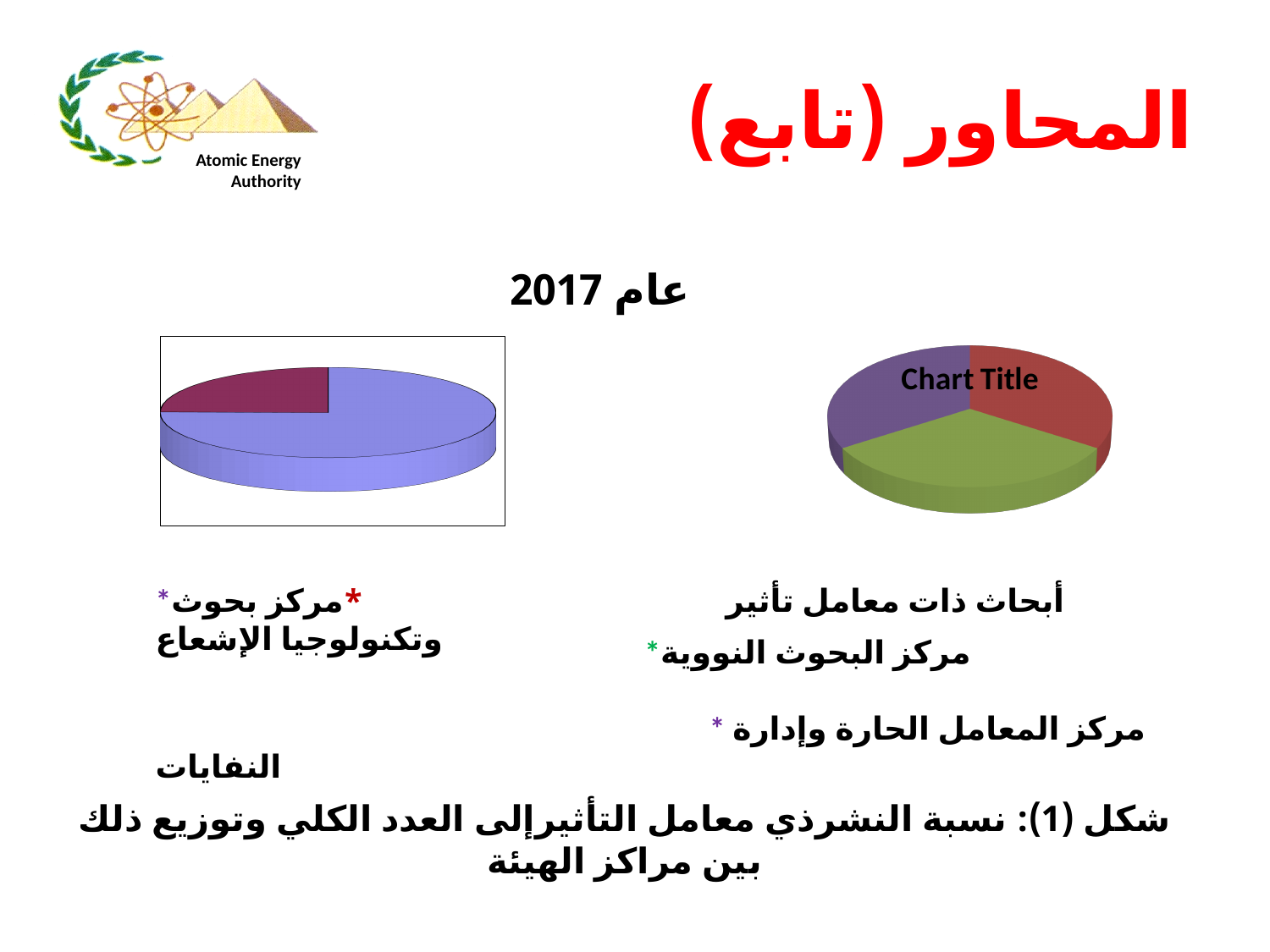
In the pie chart on the left side of the slide, which slice is the smallest? the maroon slice What is the title printed on the pie chart on the right side of the slide? Chart Title How many charts are shown on the slide? 2 In the pie chart on the left side of the slide, which slice is larger, the light blue slice or the maroon slice? the light blue slice How many slices does the pie chart on the left side of the slide have? 2 How many slices does the pie chart on the right side of the slide, titled "Chart Title", have? 3 What kind of chart is the chart on the right side of the slide, titled "Chart Title"? pie chart What kind of chart is the chart on the left side of the slide? pie chart What three colours are the slices of the pie chart on the right side of the slide? purple, red and green